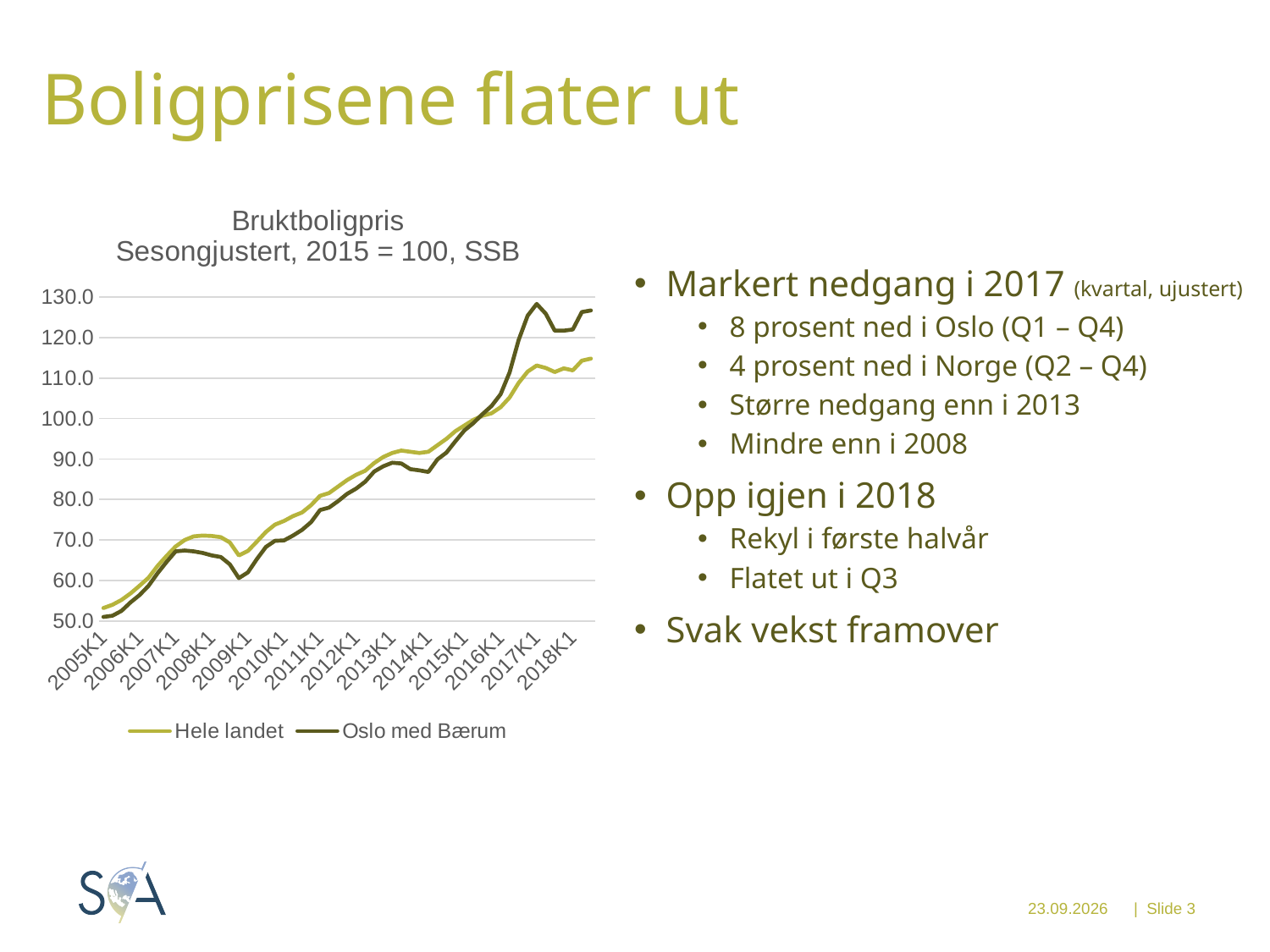
At 2017K1, which series has the higher value, Hele landet or Oslo med Bærum? Oslo med Bærum At 2009K1, which series has the higher value, Hele landet or Oslo med Bærum? Hele landet What kind of chart is shown on the slide? line chart How many year labels are shown on the x axis? 14 Is the value for Hele landet at 2005K1 greater or less than 60? less How many series does the legend list? 2 What is the title of the chart? Bruktboligpris Sesongjustert, 2015 = 100, SSB Is the value for Hele landet at 2018K1 greater or less than 110? greater What are the two series named in the legend? Hele landet and Oslo med Bærum Is the value for Oslo med Bærum at 2017K1 greater or less than 120? greater Do the values for Hele landet generally rise or fall from 2005K1 to 2018K1? rise